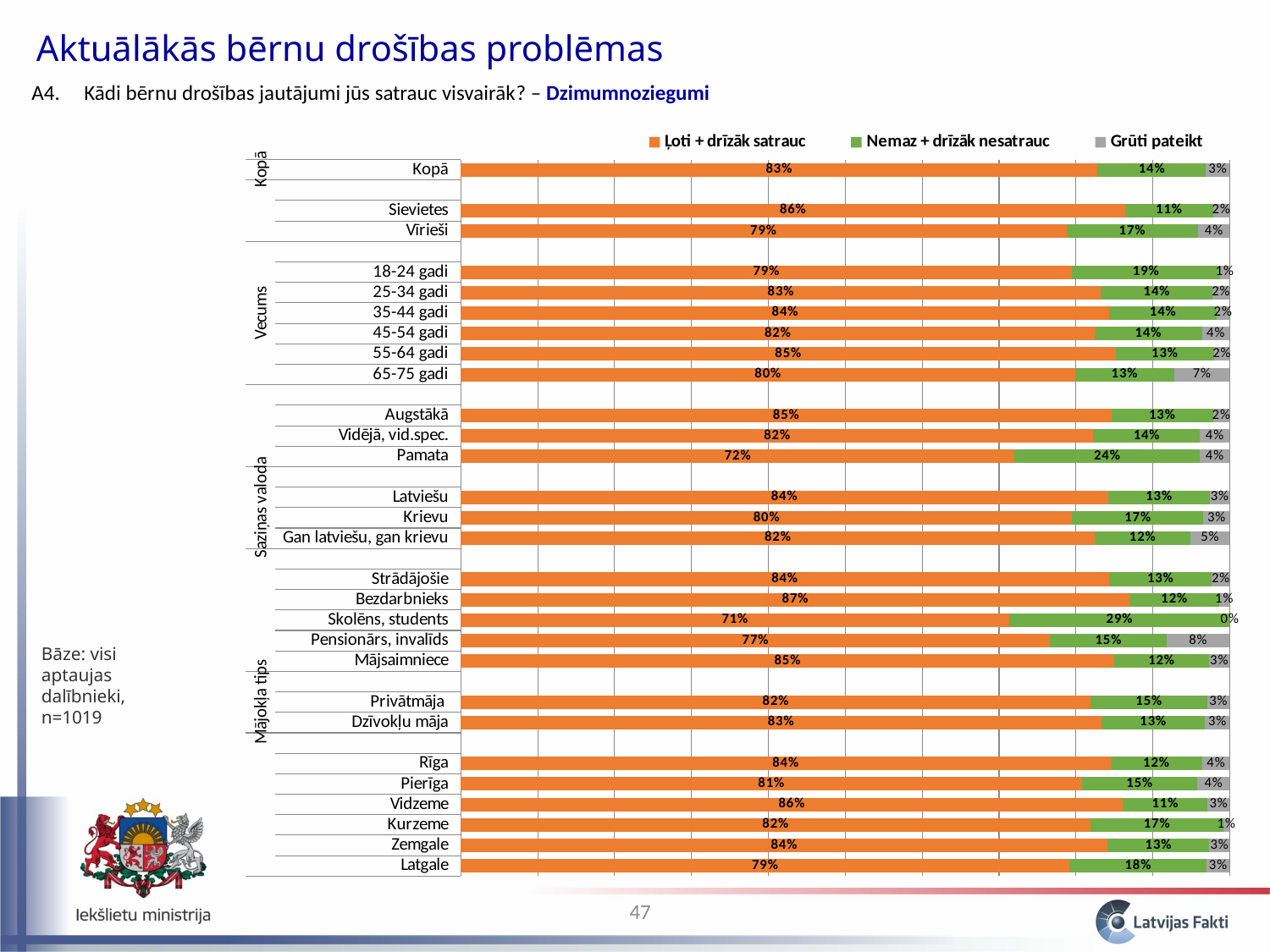
Which has a larger "Ļoti + drīzāk satrauc" value, Vidzeme or Latgale? Vidzeme What kind of chart is shown on the slide? Stacked bar chart Which category has the highest "Nemaz + drīzāk nesatrauc" value? Skolēns, students What is the difference between the "Ļoti + drīzāk satrauc" values for Sievietes and Vīrieši? 7% How many categories (rows) are plotted in the chart? 28 Which category has the lowest "Ļoti + drīzāk satrauc" value? Skolēns, students What is the "Grūti pateikt" value for Pensionārs, invalīds? 8% What is the "Ļoti + drīzāk satrauc" value for Kopā? 83% What is the "Nemaz + drīzāk nesatrauc" value for Pamata? 24% How many series does the legend list? 3 Which category has the highest "Ļoti + drīzāk satrauc" value? Bezdarbnieks Which colour represents the "Grūti pateikt" series? Grey